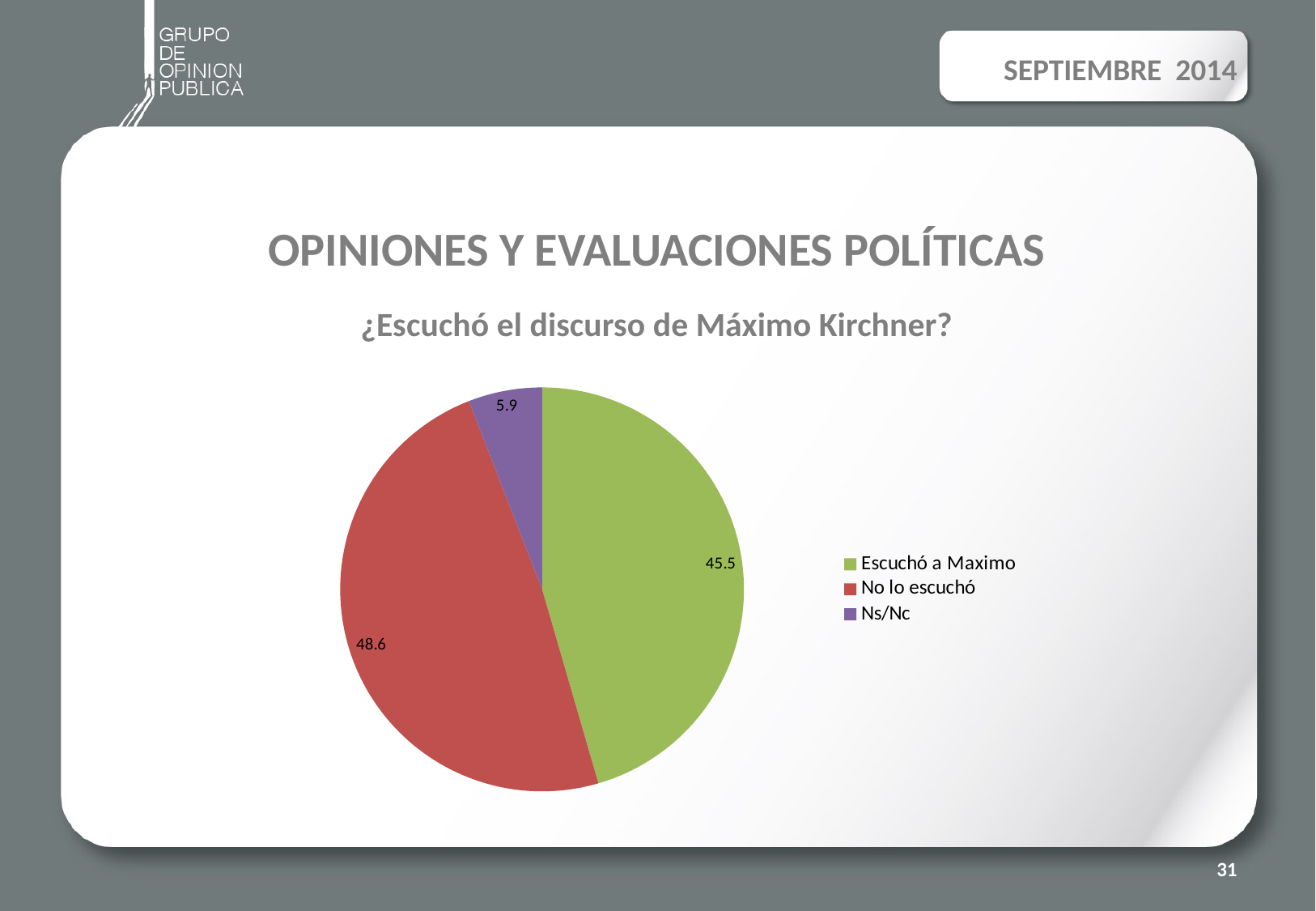
What is the difference between the values for "Escuchó a Maximo" and "Ns/Nc"? 39.6 How many categories does the pie chart show? 3 What is the difference between the values for "No lo escuchó" and "Escuchó a Maximo"? 3.1 What kind of chart is shown on the slide? Pie chart Which is larger, the value for "Escuchó a Maximo" or the value for "Ns/Nc"? Escuchó a Maximo Which category has the smallest slice of the pie? Ns/Nc What is the value for "Escuchó a Maximo"? 45.5 What is the title of the chart? ¿Escuchó el discurso de Máximo Kirchner? Which category has the largest slice of the pie? No lo escuchó What is the value for "No lo escuchó"? 48.6 What colour is the slice for "Ns/Nc"? Purple What is the value for "Ns/Nc"? 5.9